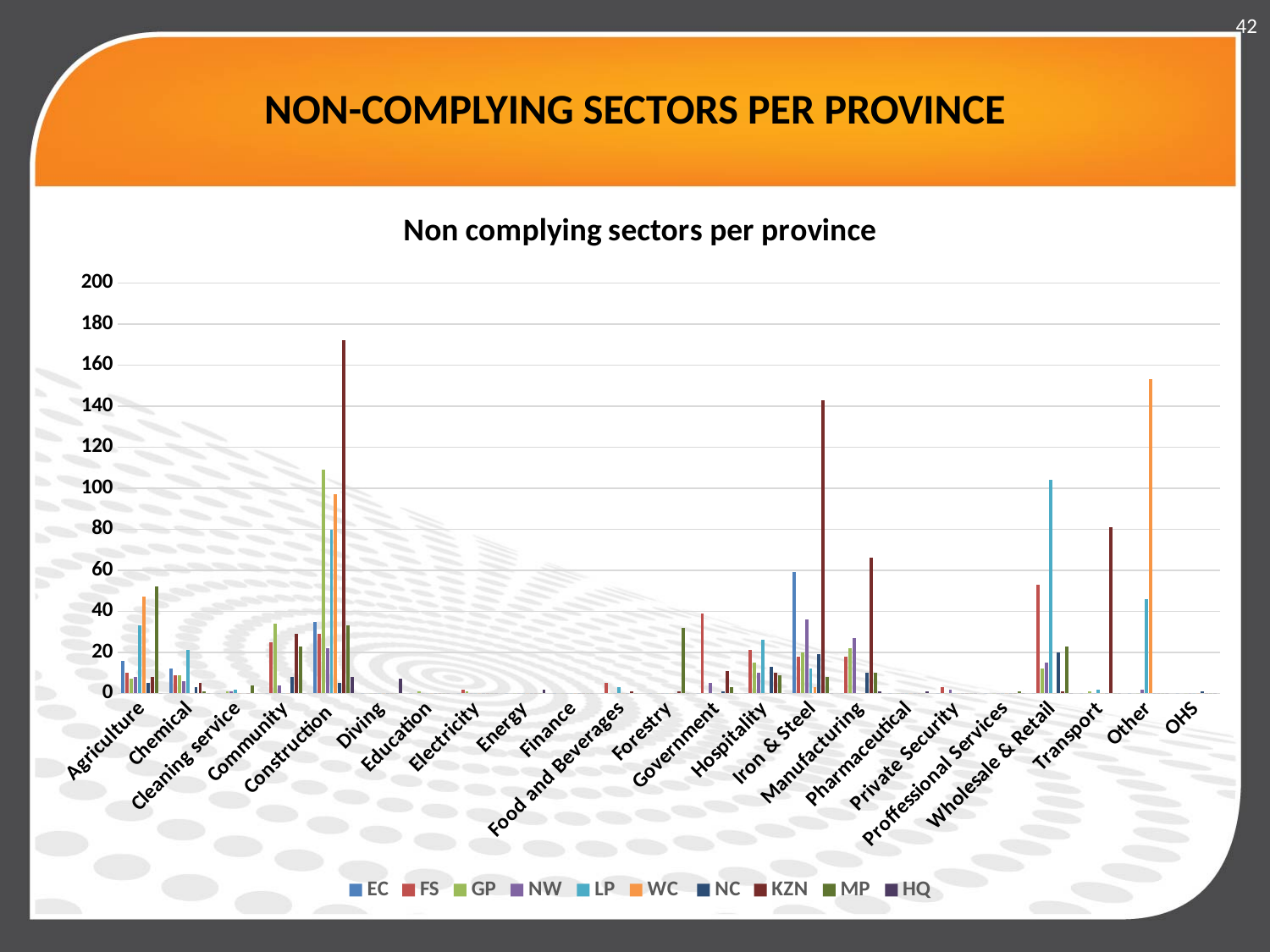
Which is larger: the KZN value for Construction or the KZN value for Iron & Steel? KZN value for Construction Is the KZN value for Iron & Steel greater or less than 120? greater Is the LP value for Wholesale & Retail greater or less than 80? greater Which sector contains the tallest bar in the chart? Construction How many series does the legend list? 10 What kind of chart is shown on the slide? bar chart How many sector categories are shown on the x axis? 23 Is the KZN value for Construction greater or less than 160? greater What is the title of the chart? Non complying sectors per province